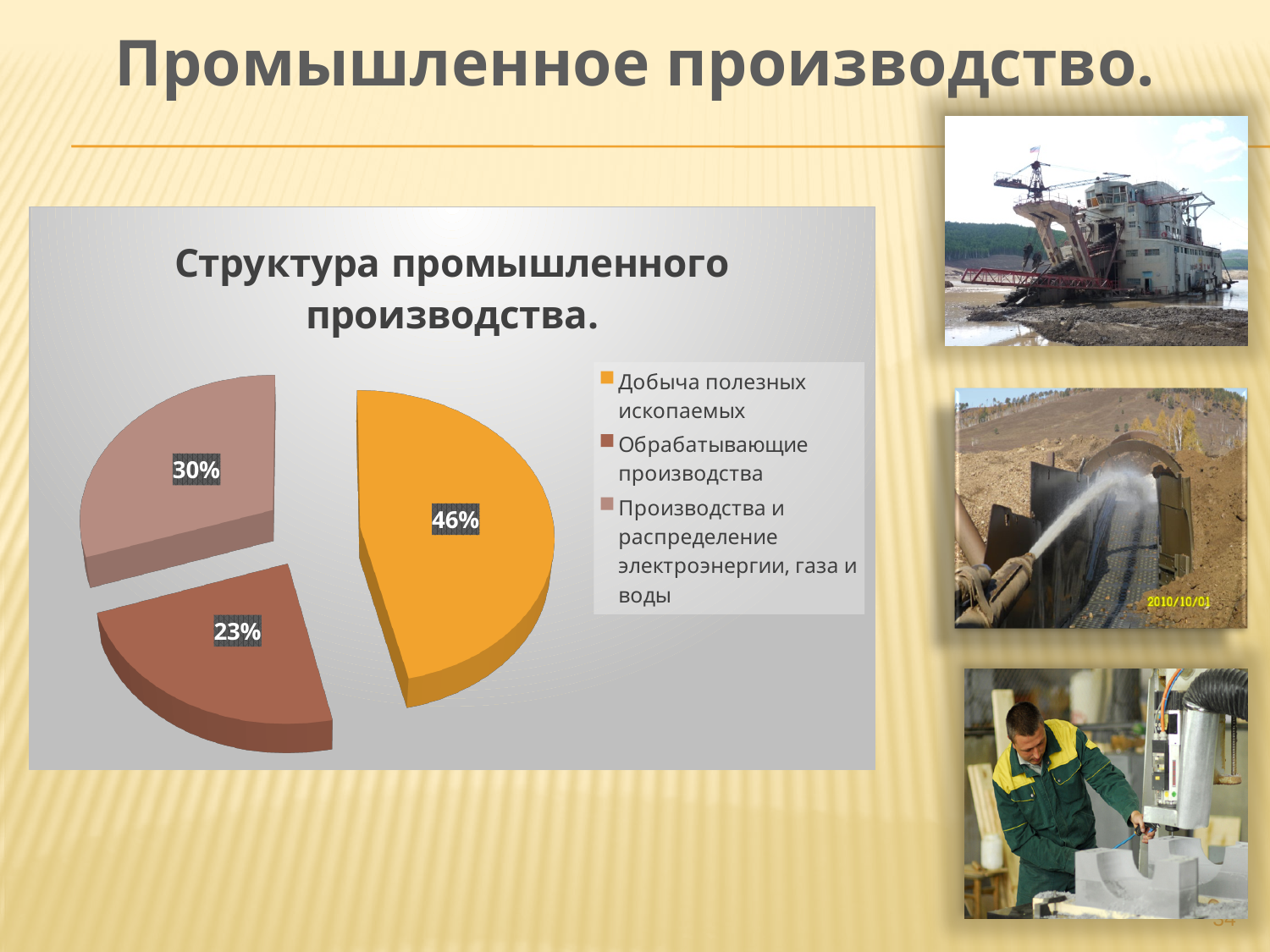
How many entries does the chart legend list? 3 What colour is the slice for Добыча полезных ископаемых? Orange What is the title of the chart? Структура промышленного производства. What share of the pie is Обрабатывающие производства? 23% What share of the pie is Добыча полезных ископаемых? 46% What kind of chart is shown on the slide? Pie chart Which category has the largest share of the pie? Добыча полезных ископаемых What share of the pie is Производства и распределение электроэнергии, газа и воды? 30% What is the difference in percentage points between Добыча полезных ископаемых and Обрабатывающие производства? 23 How many slices does the pie chart have? 3 Which is larger: the share for Обрабатывающие производства or the share for Производства и распределение электроэнергии, газа и воды? Производства и распределение электроэнергии, газа и воды Which category has the smallest share of the pie? Обрабатывающие производства